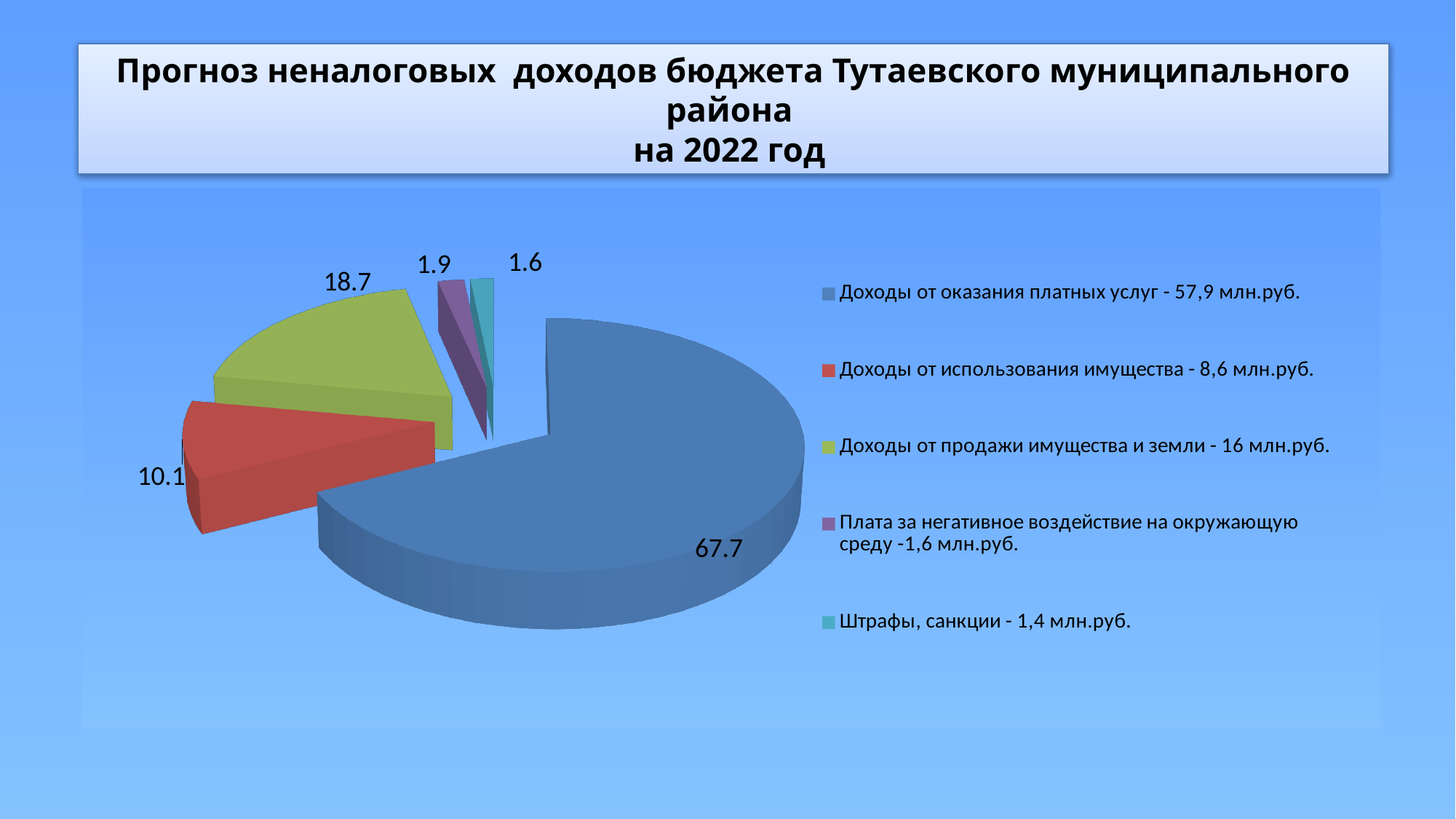
What kind of chart is shown on the slide? pie chart What is the difference between the data labels for Доходы от продажи имущества и земли and Доходы от использования имущества? 8.6 What is the data label on the slice for Доходы от использования имущества? 10.1 According to the legend, what amount in млн.руб. is given for Плата за негативное воздействие на окружающую среду? 1,6 млн.руб. Which slice is larger: Доходы от продажи имущества и земли or Доходы от использования имущества? Доходы от продажи имущества и земли What is the data label on the slice for Штрафы, санкции? 1.6 What is the data label on the slice for Доходы от оказания платных услуг? 67.7 Which category has the smallest slice of the pie? Штрафы, санкции What is the data label on the slice for Доходы от продажи имущества и земли? 18.7 According to the legend, what amount in млн.руб. is given for Доходы от оказания платных услуг? 57,9 млн.руб. Which category has the largest slice of the pie? Доходы от оказания платных услуг How many slices does the pie chart have? 5